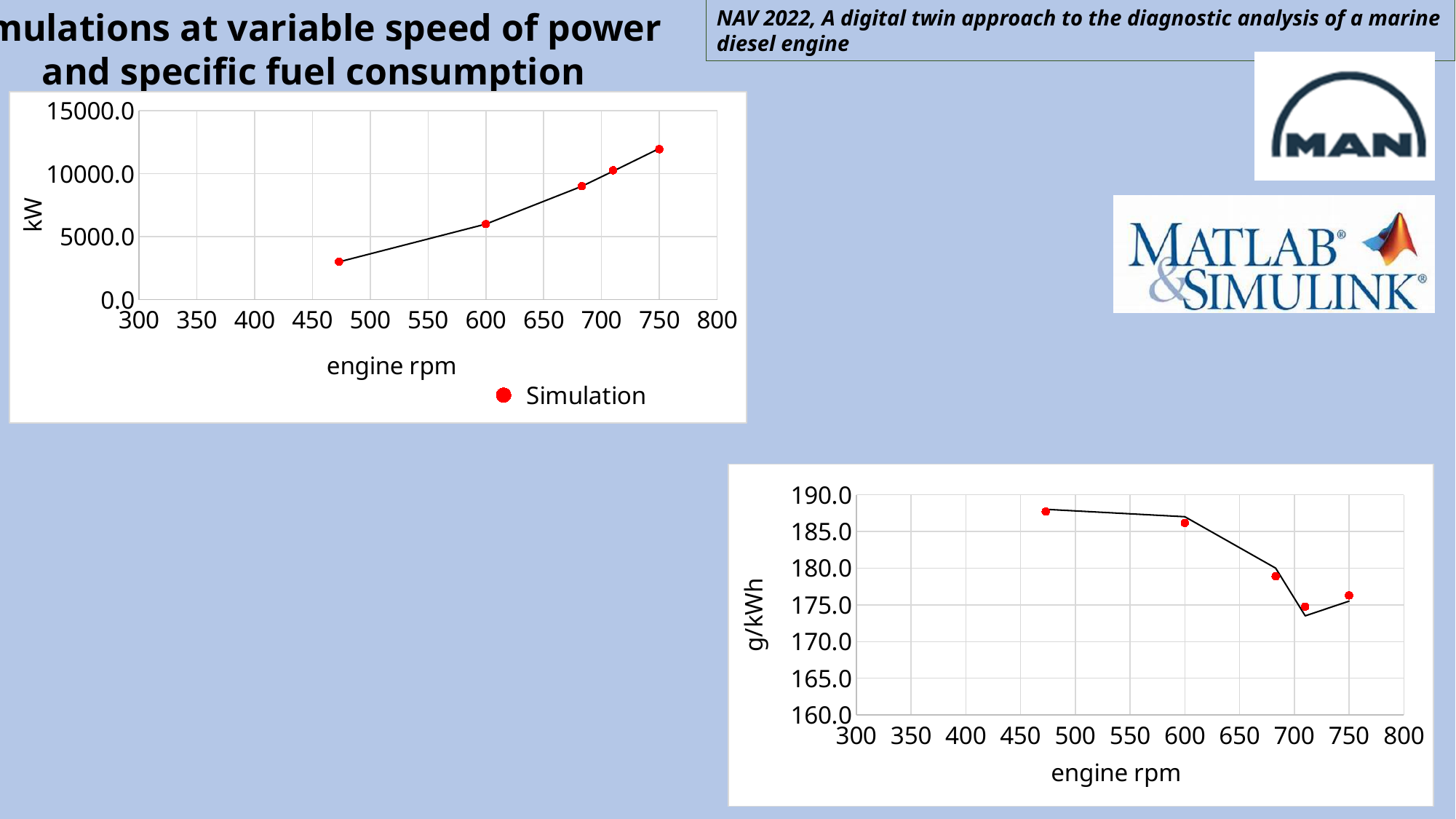
On the bottom-right chart, is the g/kWh value at 600 rpm larger or smaller than the value at 750 rpm? larger How many series does the legend of the top-left chart list? 1 On the bottom-right chart, is the g/kWh value at 600 rpm greater or less than 185.0? greater How many data points are plotted on the bottom-right chart (g/kWh vs engine rpm)? 5 What is the y-axis label of the bottom-right chart? g/kWh On the top-left chart, do the kW values rise or fall as engine rpm increases? rise What kind of chart is the top-left chart with the kW axis? line chart On the top-left chart, is the kW value at 750 rpm greater or less than 10000.0? greater What is the name of the series in the legend of the top-left chart? Simulation On the top-left chart, which plotted point has the highest kW value? the point at 750 rpm How many data points are plotted on the top-left chart (kW vs engine rpm)? 5 On the top-left chart, is the kW value at the lowest plotted rpm greater or less than 5000.0? less